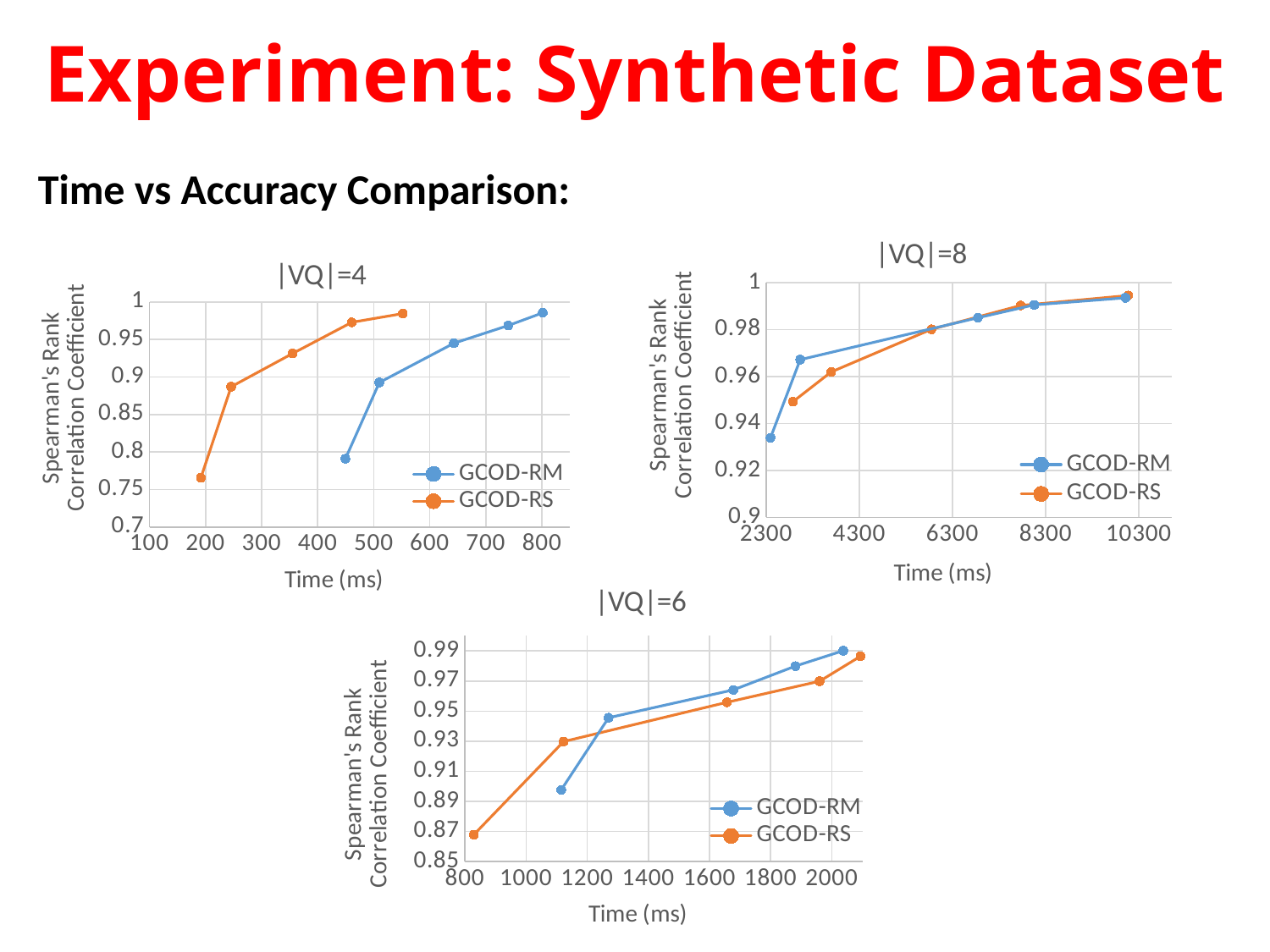
How many series does the legend of the |VQ|=8 chart list? 2 In the |VQ|=4 chart, how many data points does the GCOD-RM series have? 5 In the |VQ|=8 chart, is the first GCOD-RM point (at about 2300 ms) greater or less than 0.94? less In the |VQ|=4 chart, is the lowest GCOD-RS value greater or less than 0.8? less What are the two series named in the legend of the |VQ|=6 chart? GCOD-RM and GCOD-RS In the |VQ|=6 chart, does the GCOD-RS series rise or fall along the x axis? Rise In the |VQ|=4 chart, does the Spearman's Rank Correlation Coefficient rise or fall as Time (ms) increases? Rise In the |VQ|=4 chart, which series reaches a correlation coefficient above 0.95 at a lower time, GCOD-RM or GCOD-RS? GCOD-RS In the |VQ|=6 chart, at about 1120 ms, which series has the higher correlation coefficient, GCOD-RM or GCOD-RS? GCOD-RS What kind of chart is the |VQ|=4 chart? Line chart In the |VQ|=4 chart, is the highest GCOD-RM value greater or less than 0.95? greater What is the x-axis label on the |VQ|=8 chart? Time (ms)